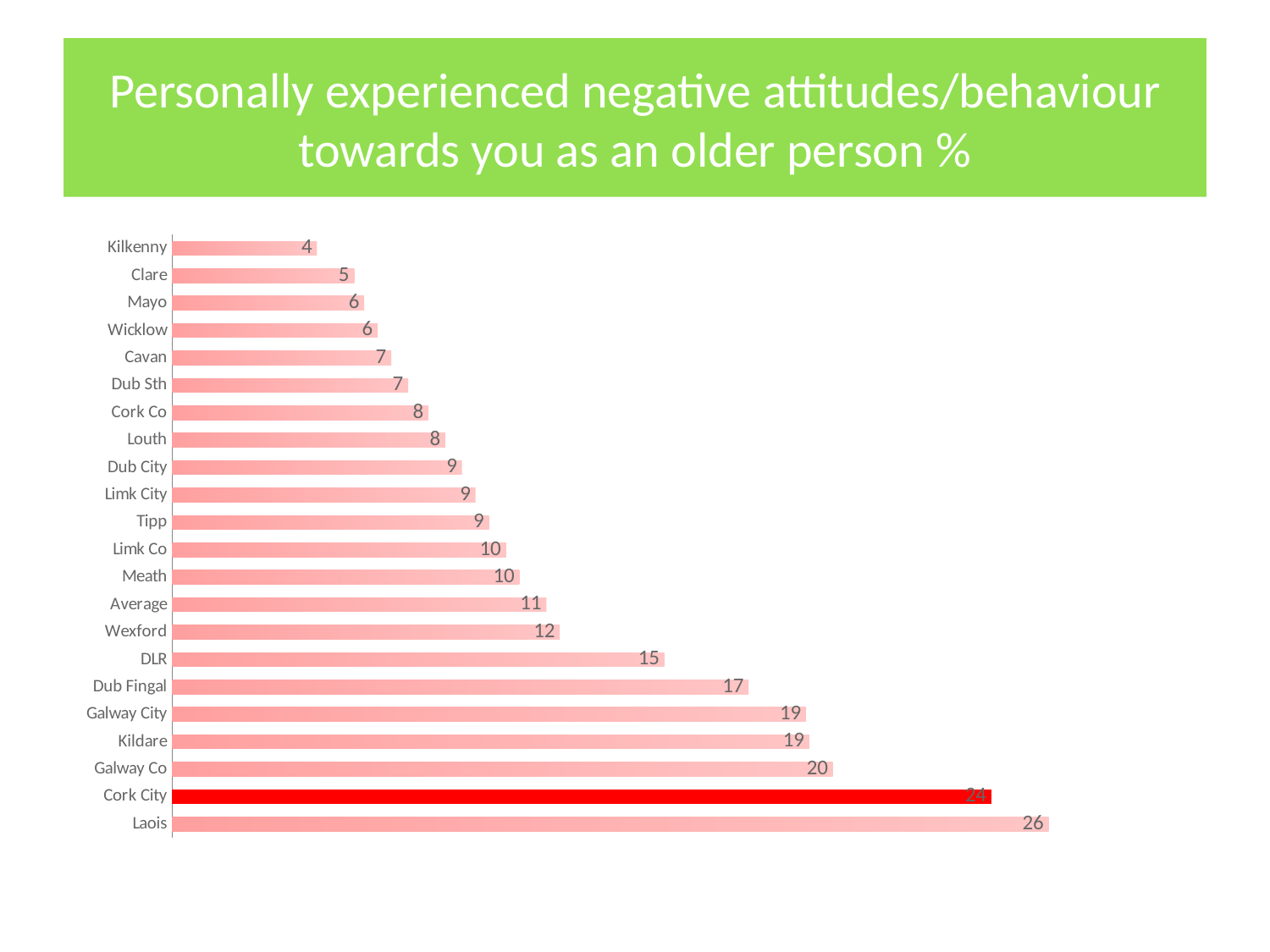
What is the difference between the values for Laois and Cork City? 2 How many categories are shown in the chart? 22 What is the value for Average? 11 What is the value for Dub Fingal? 17 Which bar is highlighted in a different colour (solid red) from the others? Cork City Which category has the highest value? Laois Which is larger, the value for DLR or the value for Wexford? DLR What is the value for Cork City? 24 What is the difference between the values for Galway Co and Kilkenny? 16 What is the value for Laois? 26 What kind of chart is shown on the slide? Bar chart Which category has the lowest value? Kilkenny